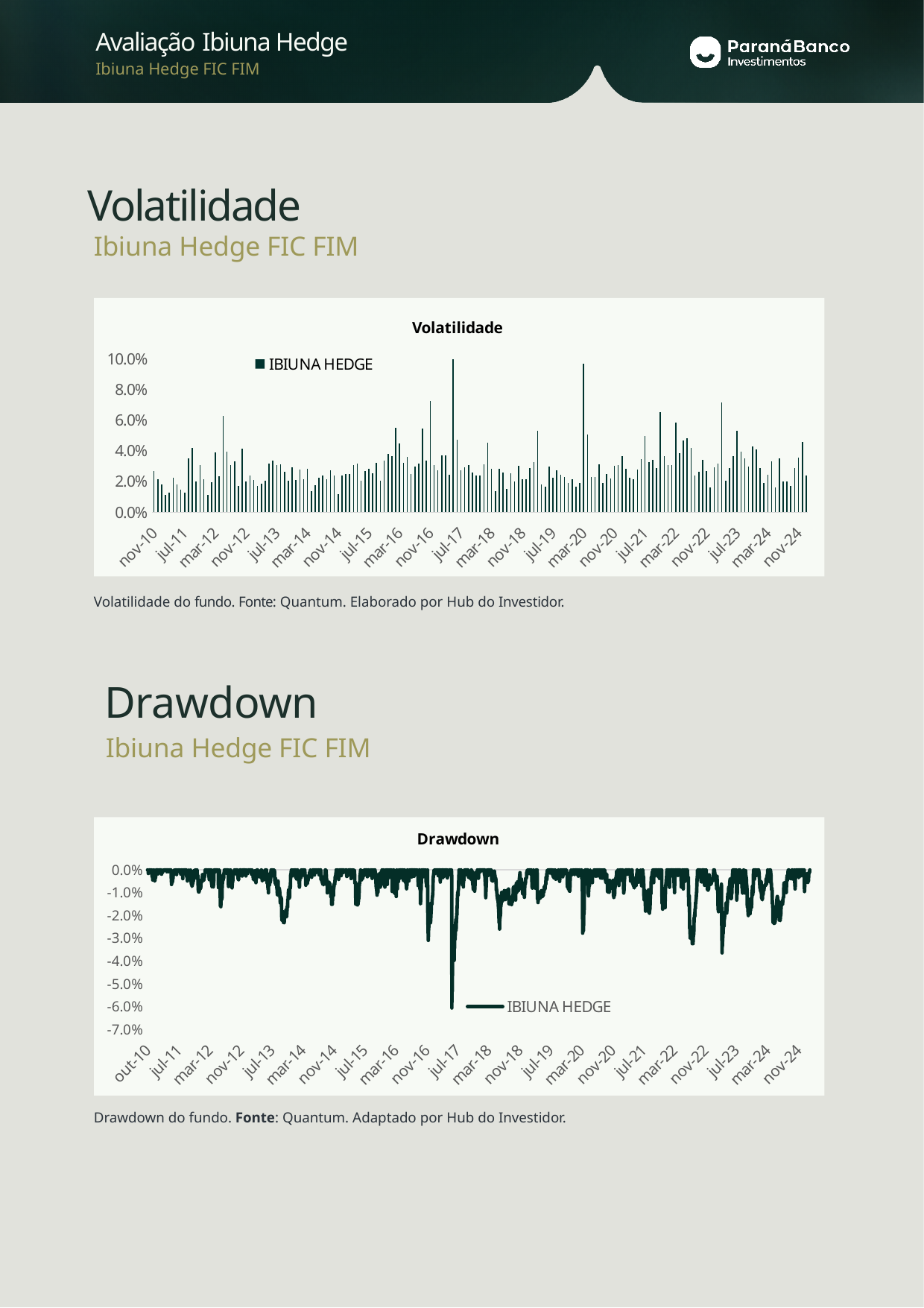
In the Drawdown chart, is the dip near jul-23 greater or less than -3.0%? less What kind of chart is the Drawdown chart? line chart In the Volatilidade chart, is the first bar at nov-10 greater or less than 2.0%? greater What is the title of the lower chart on the slide? Drawdown What is the name of the series shown in the Volatilidade chart's legend? IBIUNA HEDGE In the Volatilidade chart, is the tallest bar greater or less than 8.0%? greater What kind of chart is the Volatilidade chart? bar chart What is the highest value shown on the y axis of the Volatilidade chart? 10.0% How many series does the legend of the Drawdown chart list? 1 In the Drawdown chart, near which x-axis label does the deepest drawdown occur? jul-17 How many series does the legend of the Volatilidade chart list? 1